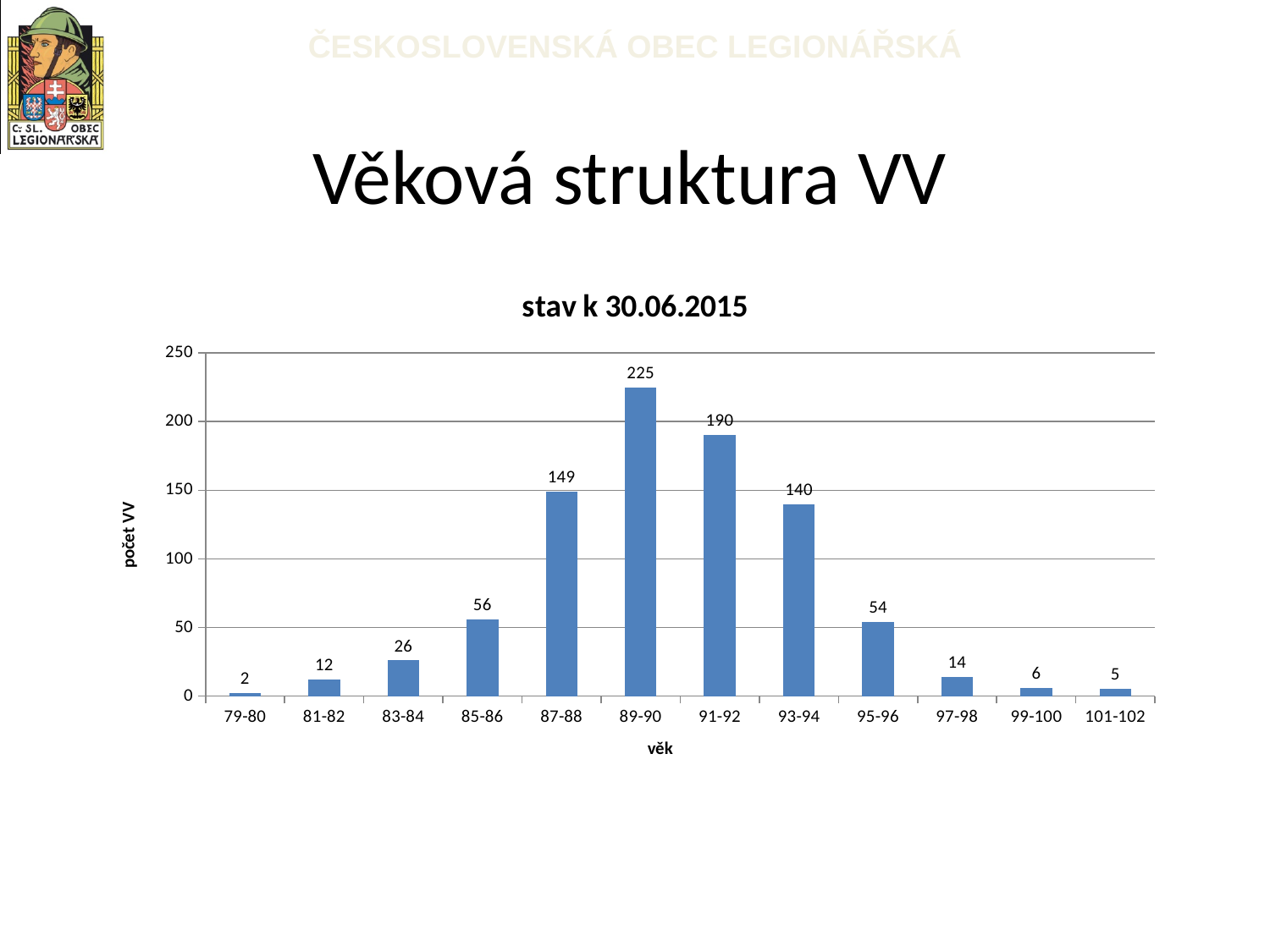
What is the title of the chart? stav k 30.06.2015 Which age group has the highest value? 89-90 What is the value for the 85-86 age group? 56 Which is larger, the value for 83-84 or the value for 95-96? 95-96 What is the value for the 97-98 age group? 14 What is the difference between the values for 87-88 and 93-94? 9 What kind of chart is this? bar chart What is the difference between the values for 89-90 and 91-92? 35 What is the label of the vertical axis? počet VV How many age groups are shown on the x axis? 12 What is the value for the 89-90 age group? 225 Which age group has the lowest value? 79-80